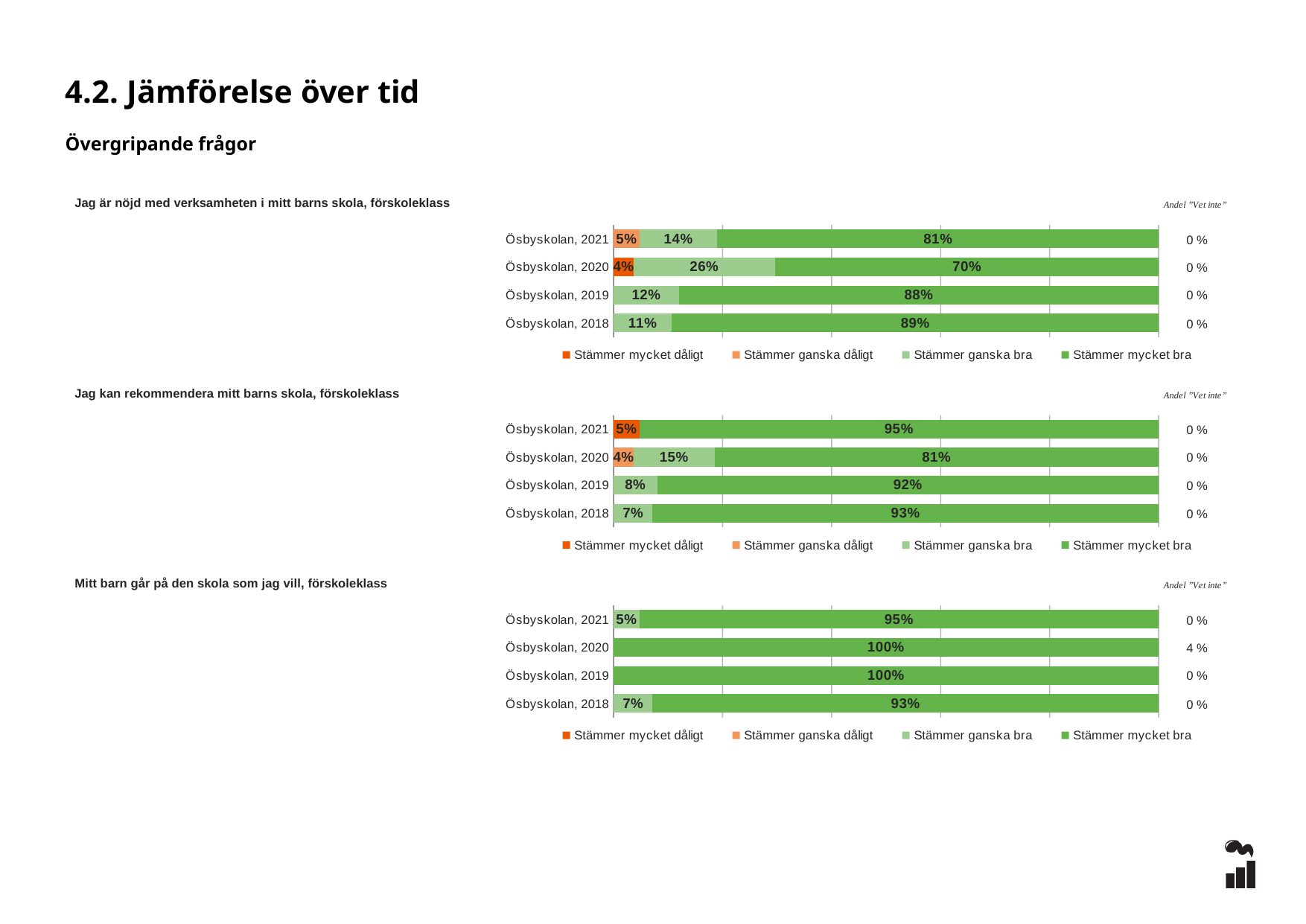
How many bars (years) does the chart 'Mitt barn går på den skola som jag vill, förskoleklass' show? 4 In the chart 'Jag kan rekommendera mitt barns skola, förskoleklass', which is larger, the 'Stämmer mycket bra' value for Ösbyskolan, 2019 or for Ösbyskolan, 2018? Ösbyskolan, 2018 In the chart 'Jag kan rekommendera mitt barns skola, förskoleklass', what is the 'Stämmer ganska bra' value for Ösbyskolan, 2020? 15% In the chart 'Jag kan rekommendera mitt barns skola, förskoleklass', what is the 'Stämmer mycket bra' value for Ösbyskolan, 2021? 95% In the chart 'Jag är nöjd med verksamheten i mitt barns skola, förskoleklass', what is the 'Stämmer ganska bra' value for Ösbyskolan, 2020? 26% How many series does the legend of the chart 'Jag kan rekommendera mitt barns skola, förskoleklass' list? 4 In the chart 'Mitt barn går på den skola som jag vill, förskoleklass', what is the 'Andel Vet inte' value for Ösbyskolan, 2020? 4 % In the chart 'Jag är nöjd med verksamheten i mitt barns skola, förskoleklass', which year has the highest 'Stämmer mycket bra' value? Ösbyskolan, 2018 In the chart 'Jag är nöjd med verksamheten i mitt barns skola, förskoleklass', what is the difference between the 'Stämmer mycket bra' values for Ösbyskolan, 2019 and Ösbyskolan, 2020? 18% In the chart 'Mitt barn går på den skola som jag vill, förskoleklass', what is the 'Stämmer mycket bra' value for Ösbyskolan, 2020? 100% In the chart 'Jag är nöjd med verksamheten i mitt barns skola, förskoleklass', what is the 'Stämmer mycket bra' value for Ösbyskolan, 2021? 81% In the chart 'Jag är nöjd med verksamheten i mitt barns skola, förskoleklass', which year has the lowest 'Stämmer mycket bra' value? Ösbyskolan, 2020